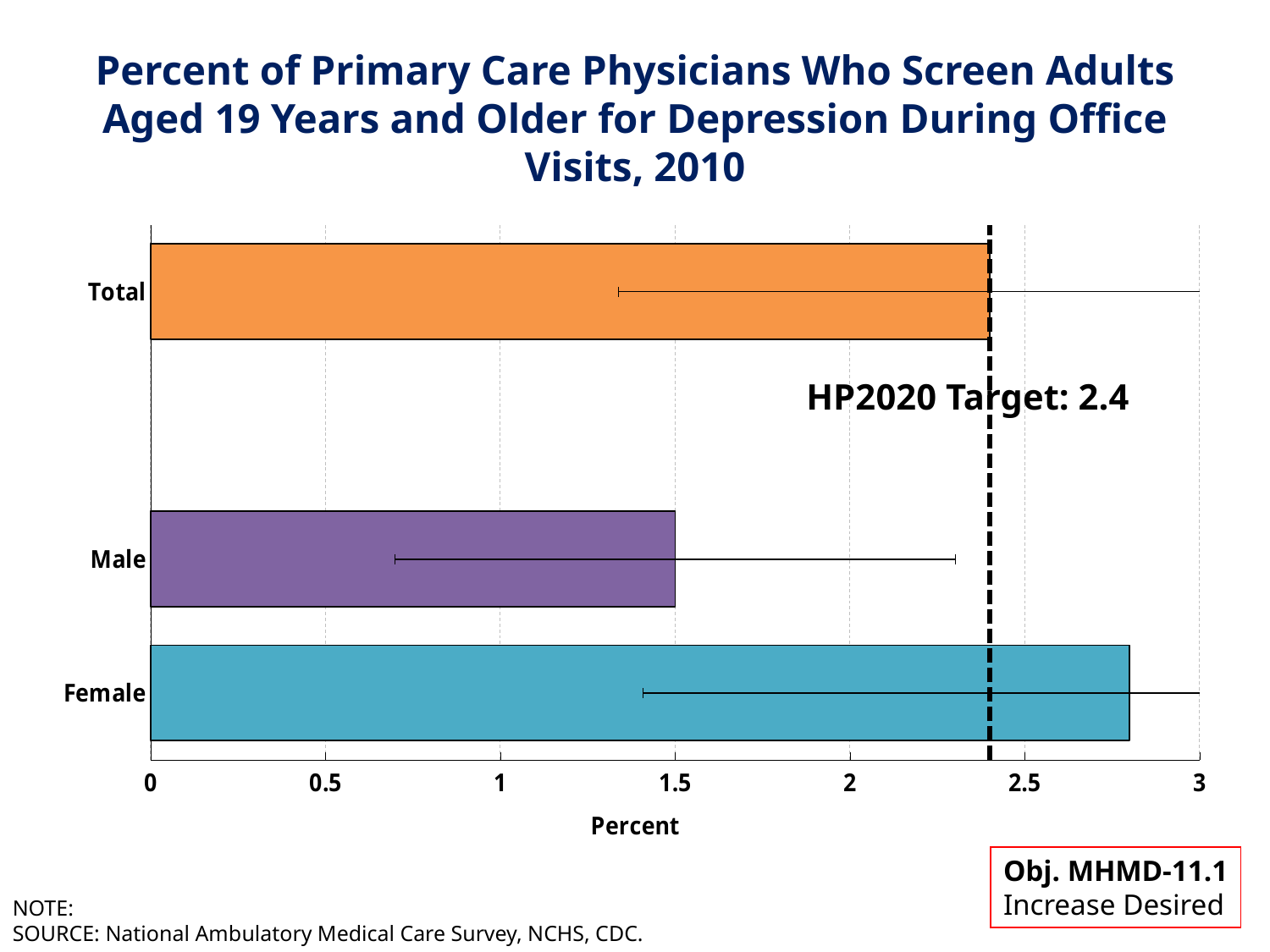
Which is larger, the value for Total or the value for Male? Total Is the value for Male greater or less than 2? less What kind of chart is shown on the slide? bar chart Which category has the lowest value? Male How many categories are plotted in the chart? 3 What is the HP2020 Target value shown on the chart? 2.4 Is the value for Total greater or less than 2? greater Which category has the highest value? Female What is the label of the horizontal axis? Percent What is the value for Male? 1.5 Is the value for Female greater or less than 2.5? greater Which is larger, the value for Female or the value for Male? Female